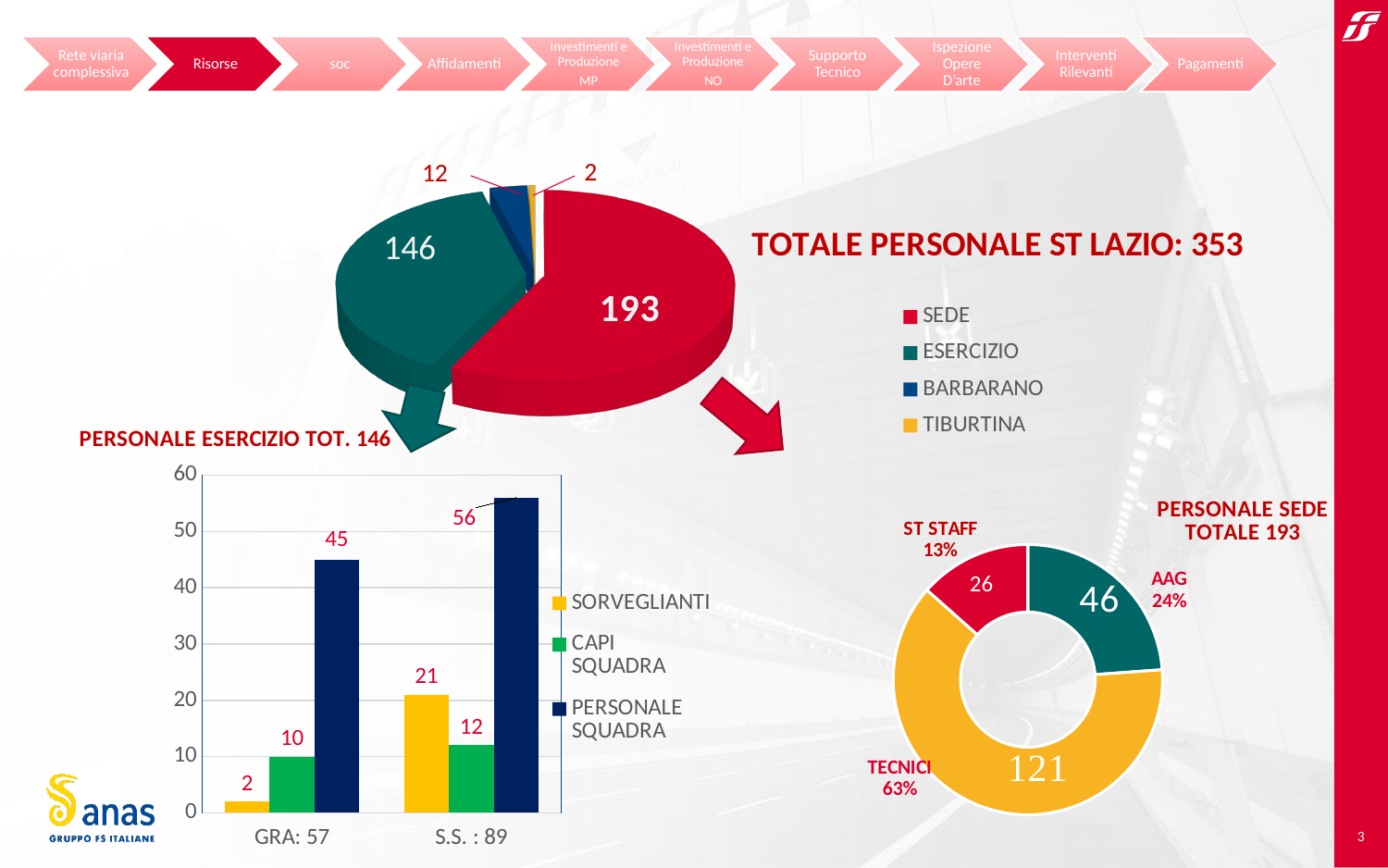
In the donut chart titled 'PERSONALE SEDE TOTALE 193', what is the value for TECNICI? 121 In the pie chart titled 'TOTALE PERSONALE ST LAZIO: 353', what is the difference between SEDE and ESERCIZIO? 47 In the bar chart titled 'PERSONALE ESERCIZIO TOT. 146', what is the value for PERSONALE SQUADRA in the GRA: 57 group? 45 In the bar chart titled 'PERSONALE ESERCIZIO TOT. 146', is CAPI SQUADRA larger for GRA: 57 or for S.S. : 89? S.S. : 89 In the bar chart titled 'PERSONALE ESERCIZIO TOT. 146', which series has the highest value in the S.S. : 89 group? PERSONALE SQUADRA In the pie chart titled 'TOTALE PERSONALE ST LAZIO: 353', what is the value for SEDE? 193 In the bar chart titled 'PERSONALE ESERCIZIO TOT. 146', what is the value for SORVEGLIANTI in the S.S. : 89 group? 21 How many entries does the legend of the pie chart titled 'TOTALE PERSONALE ST LAZIO: 353' list? 4 In the donut chart titled 'PERSONALE SEDE TOTALE 193', what share does AAG represent? 24% What kind of chart is the one titled 'PERSONALE ESERCIZIO TOT. 146'? Bar chart In the donut chart titled 'PERSONALE SEDE TOTALE 193', what is the difference between AAG and ST STAFF? 20 In the pie chart titled 'TOTALE PERSONALE ST LAZIO: 353', which category has the smallest value? TIBURTINA